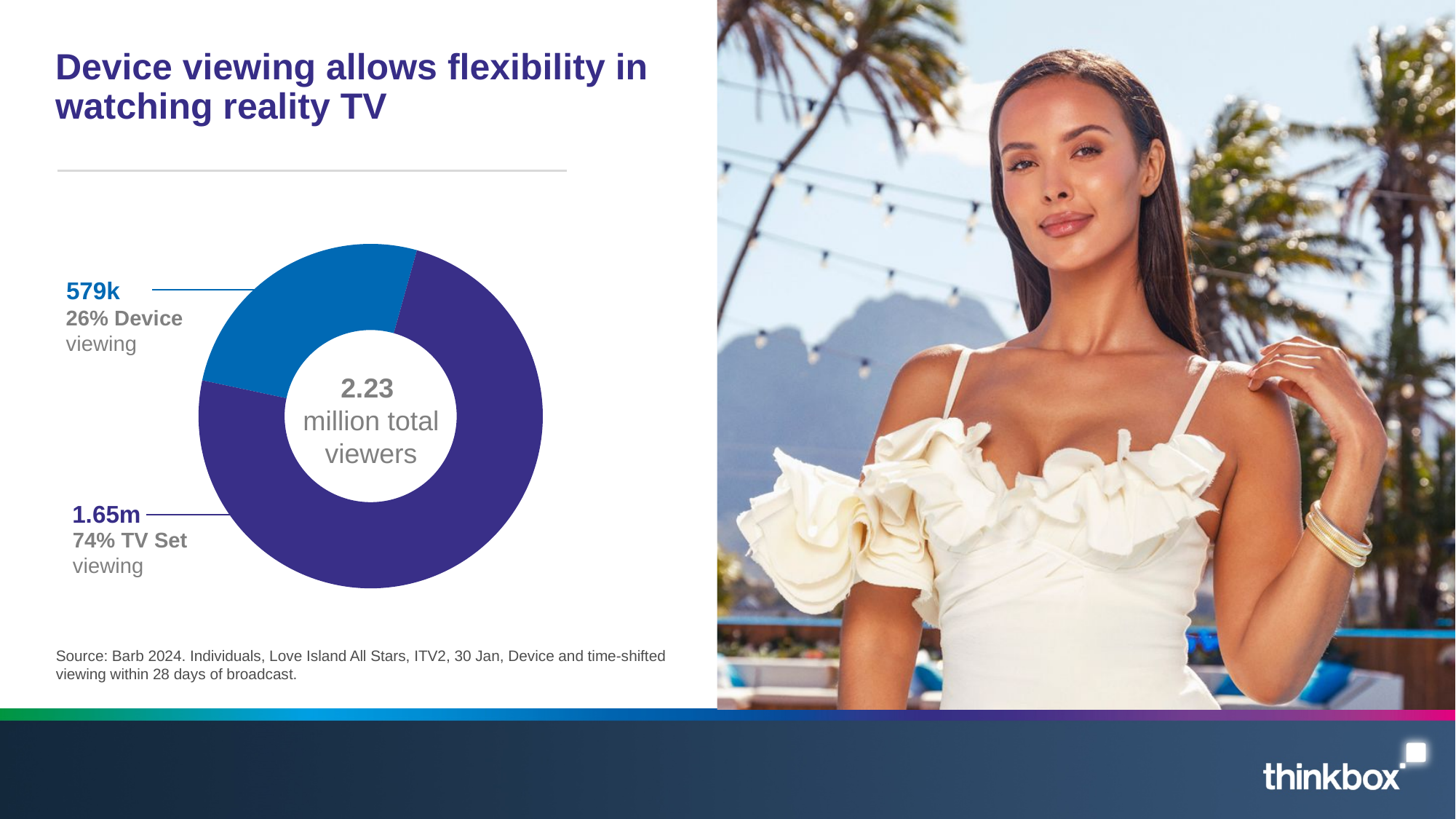
Which segment has the smallest share of the chart? Device viewing How many viewers does the chart show for Device viewing? 579k Which segment is larger, Device viewing or TV Set viewing? TV Set viewing What is the total number of viewers shown in the centre of the chart? 2.23 million How many segments does the doughnut chart have? 2 What share of viewing is TV Set viewing? 74% What colour is the Device viewing segment? Blue What share of viewing is Device viewing? 26% What kind of chart is shown on the slide? Doughnut (pie) chart How many viewers does the chart show for TV Set viewing? 1.65m What is the title of the slide containing the chart? Device viewing allows flexibility in watching reality TV What is the difference in percentage points between TV Set viewing and Device viewing? 48 percentage points